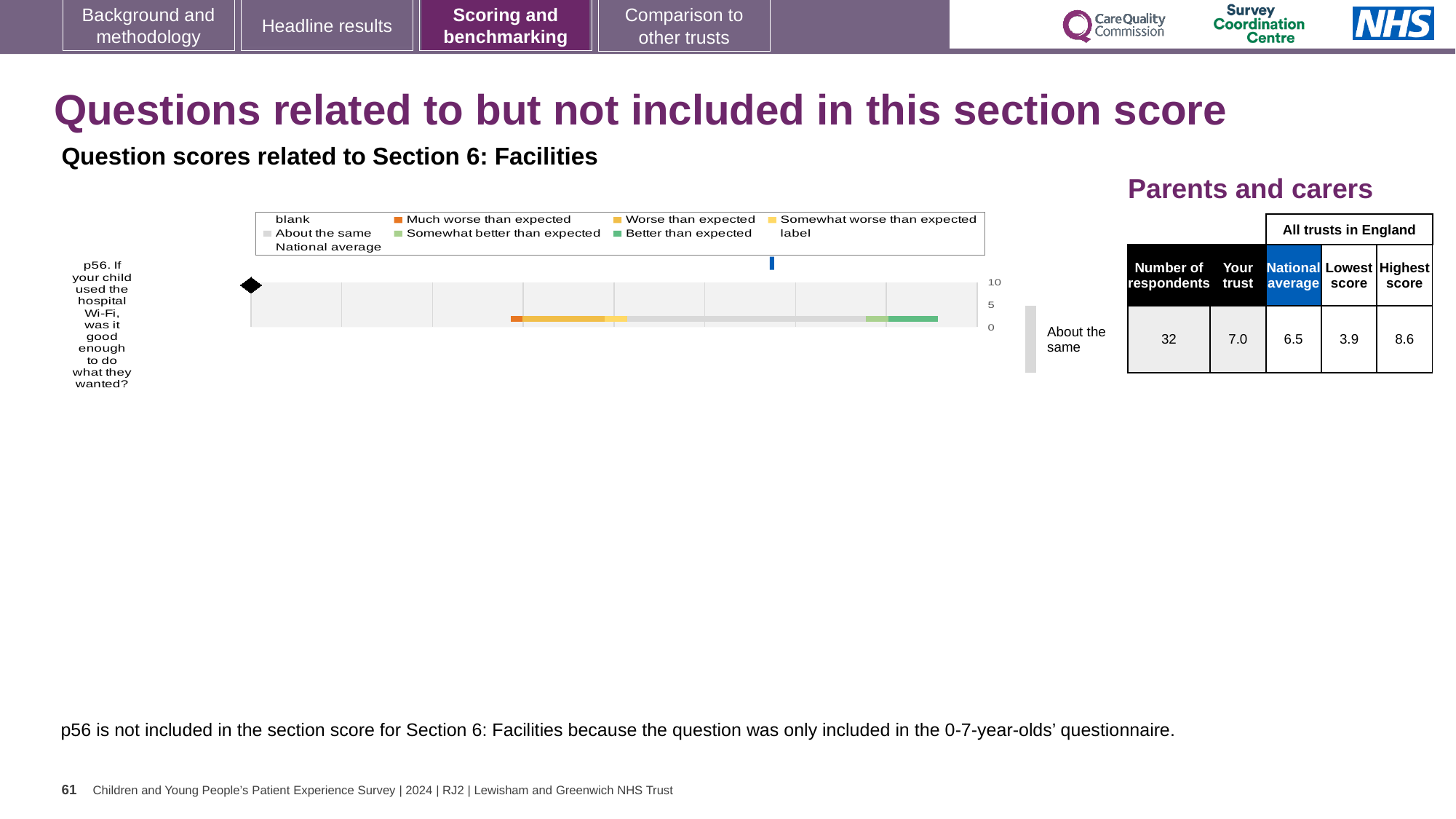
What is the highest value shown on the chart's axis? 10 How many respondents answered question p56? 32 What is the 'Your trust' score for question p56? 7.0 How many questions are plotted in the chart? 1 What is the lowest score among all trusts in England for question p56? 3.9 What kind of chart is used to show the benchmarking for question p56? Bar chart What is the national average score for question p56? 6.5 Which is larger for question p56, the 'Your trust' score or the national average? Your trust What is the highest score among all trusts in England for question p56? 8.6 Which colour in the legend represents 'Much worse than expected'? Orange What benchmark category is question p56 placed in? About the same What is the difference between the highest score and the lowest score for question p56? 4.7